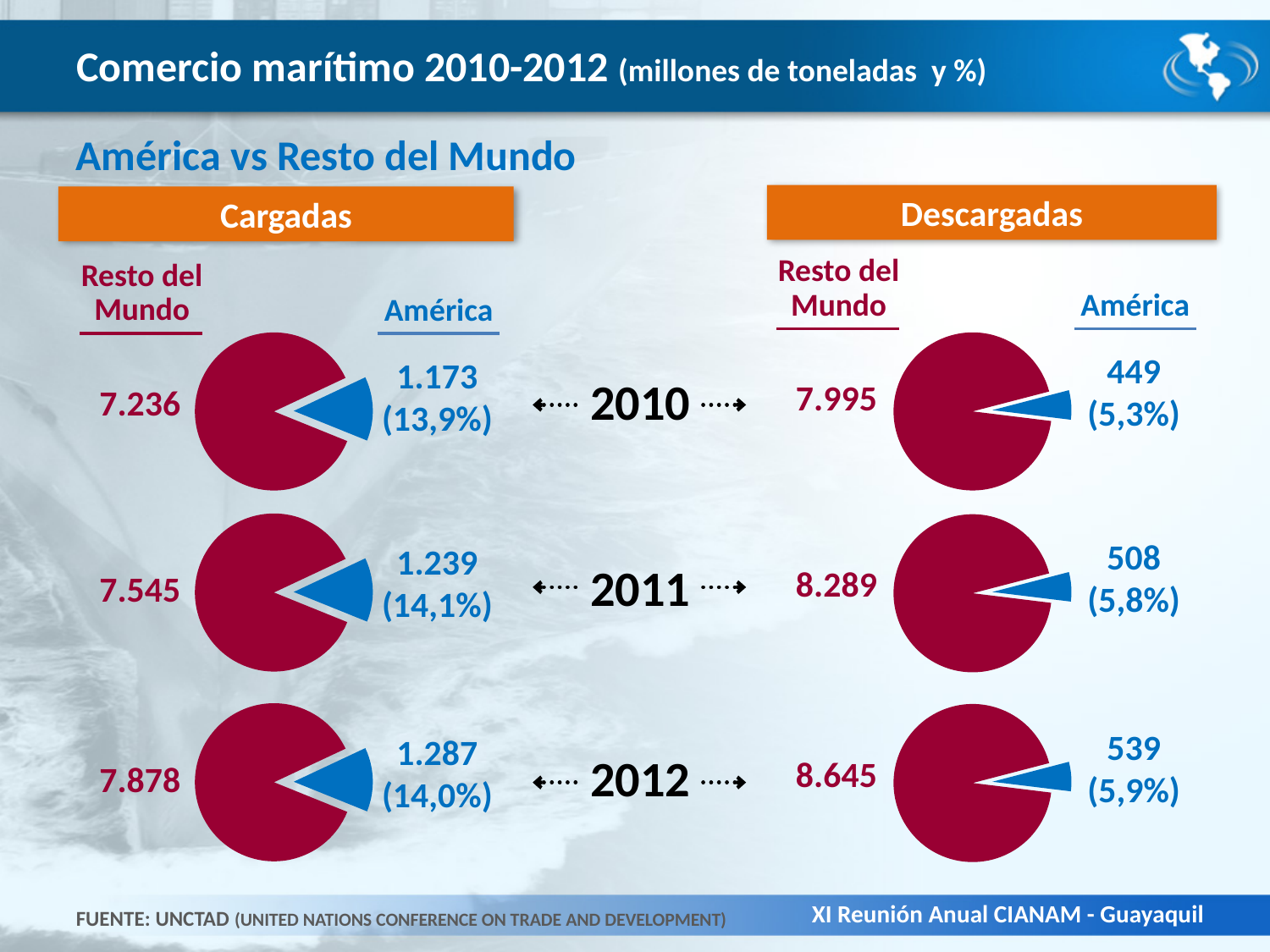
In the Descargadas 2012 pie chart, what is the value for América? 539 How many pie charts are shown on the slide? 6 In the Cargadas 2011 pie chart, which is larger, Resto del Mundo or América? Resto del Mundo In the Descargadas 2012 pie chart, what is the total of Resto del Mundo and América? 9.184 In the Cargadas 2012 pie chart, what is the difference between Resto del Mundo and América? 6.591 In the Descargadas 2011 pie chart, what is the value for Resto del Mundo? 8.289 In the Cargadas 2010 pie chart, what is the value for Resto del Mundo? 7.236 What kind of chart is used on the slide? pie chart In the Descargadas 2010 pie chart, what share of the pie does América represent? 5,3% In the Cargadas 2010 pie chart, what share of the pie does América represent? 13,9% Across the Cargadas pie charts, does the value for América rise or fall from 2010 to 2012? rise In the Cargadas 2011 pie chart, what is the value for América? 1.239